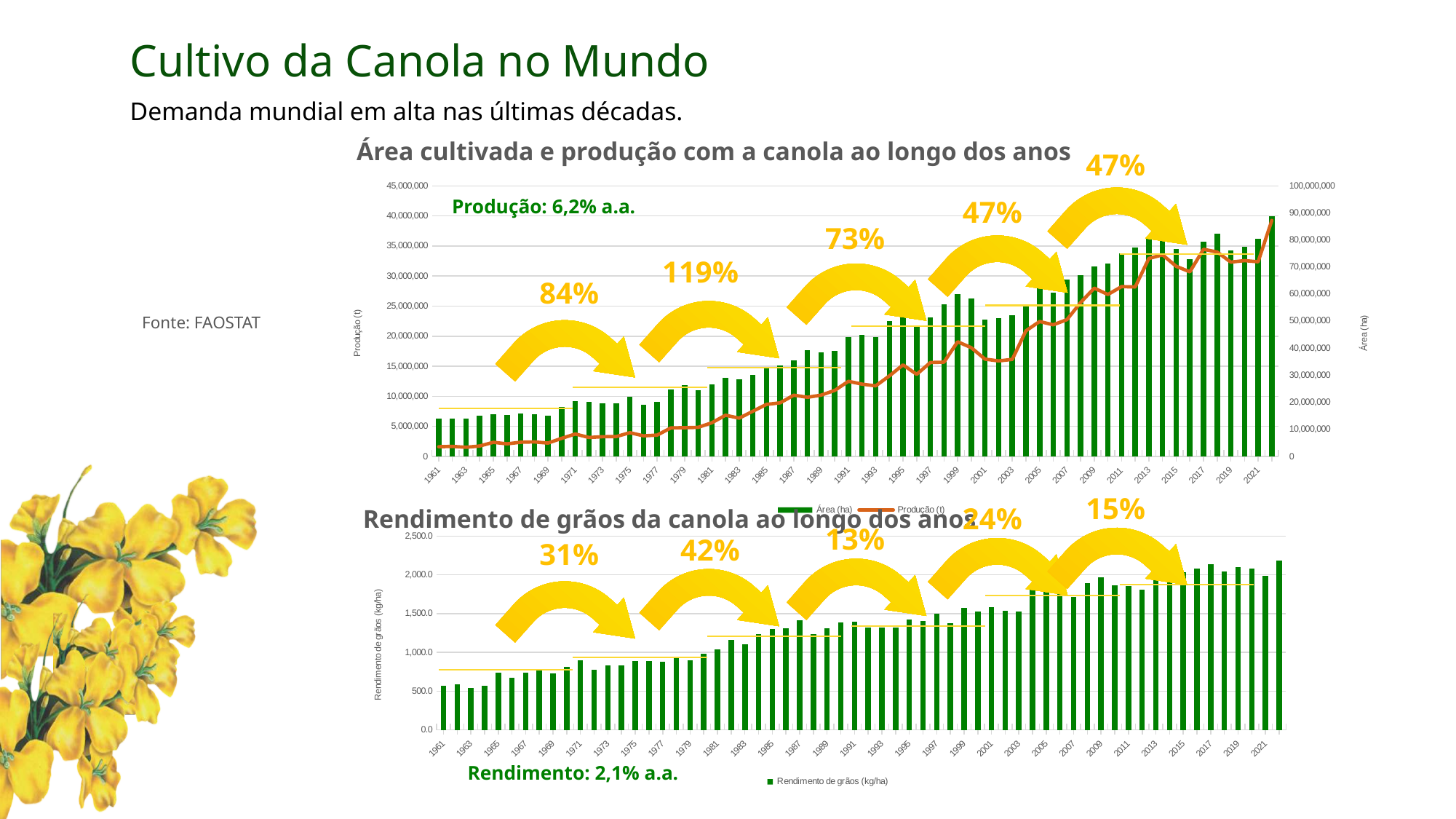
What is the title of the lower chart on the slide? Rendimento de grãos da canola ao longo dos anos How many series does the legend of the 'Rendimento de grãos da canola ao longo dos anos' chart list? 1 In the 'Rendimento de grãos da canola ao longo dos anos' chart, do the values generally rise or fall from 1961 to 2021? rise In the 'Rendimento de grãos da canola ao longo dos anos' chart, is the value for 1991 greater or less than 1,500? less How many series does the legend of the 'Área cultivada e produção com a canola ao longo dos anos' chart list? 2 In the 'Área cultivada e produção com a canola ao longo dos anos' chart, does the Produção (t) line generally rise or fall from 1961 to 2021? rise In the 'Área cultivada e produção com a canola ao longo dos anos' chart, which series is drawn as a line? Produção (t) In the 'Rendimento de grãos da canola ao longo dos anos' chart, which year has the larger value, 1961 or 2021? 2021 In the 'Rendimento de grãos da canola ao longo dos anos' chart, is the value for 1961 greater or less than 1,000? less In the 'Rendimento de grãos da canola ao longo dos anos' chart, is the value for 2011 greater or less than 1,500? greater What kind of chart is the 'Rendimento de grãos da canola ao longo dos anos' chart? bar chart